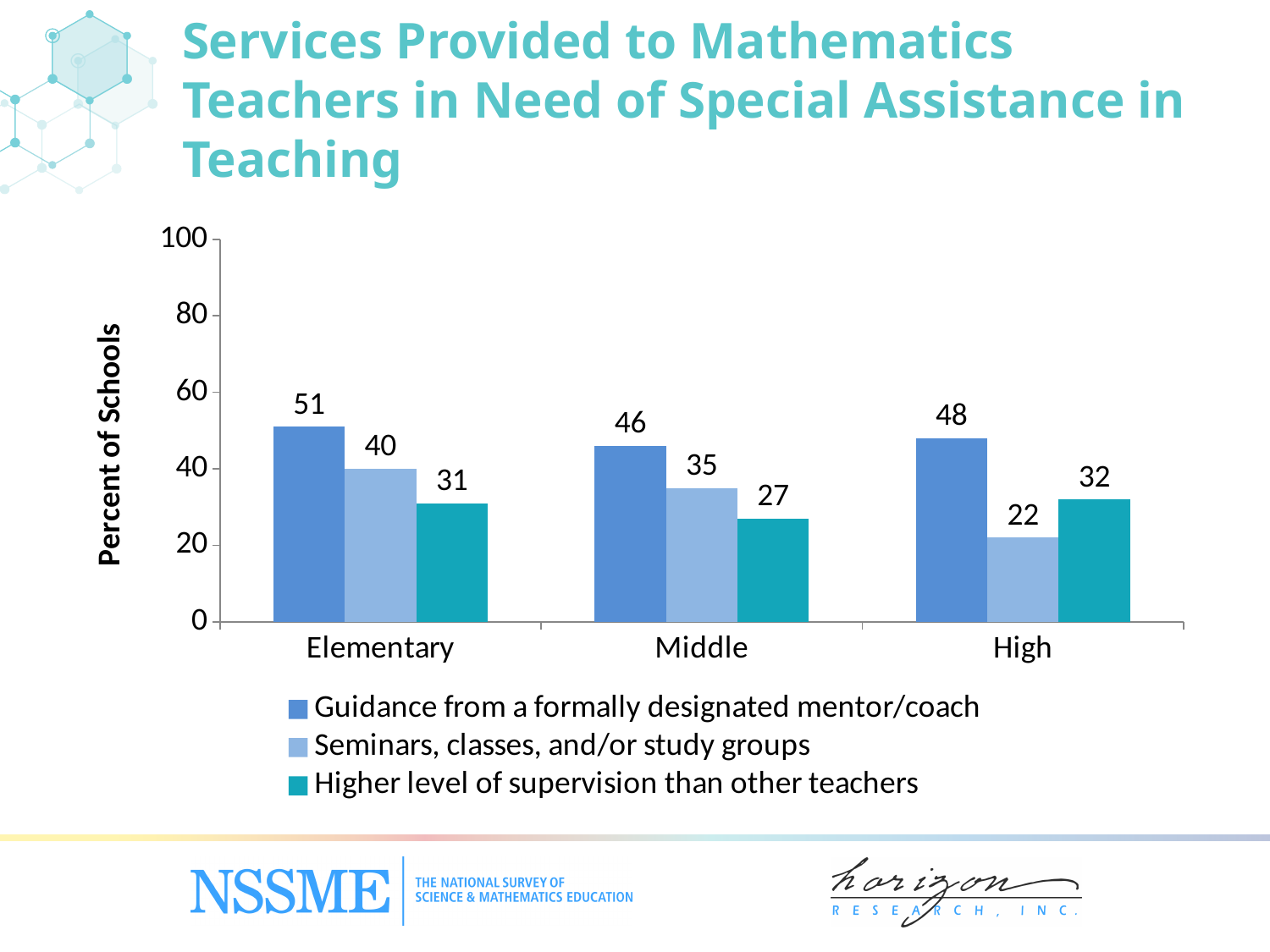
Which school level has the highest value for guidance from a formally designated mentor/coach? Elementary What is the value for seminars, classes, and/or study groups at high schools? 22 Is the value for guidance from a formally designated mentor/coach at middle schools greater or less than 40? greater What kind of chart is shown on the slide? Bar chart What percent of elementary schools provide guidance from a formally designated mentor/coach? 51 Which is larger at high schools: seminars, classes, and/or study groups or higher level of supervision than other teachers? Higher level of supervision than other teachers Which school level has the lowest value for seminars, classes, and/or study groups? High What is the difference between the elementary and high school values for seminars, classes, and/or study groups? 18 What is the value for higher level of supervision than other teachers at middle schools? 27 How many school levels are shown on the x axis? 3 What is the label of the y axis? Percent of Schools How many series does the legend list? 3